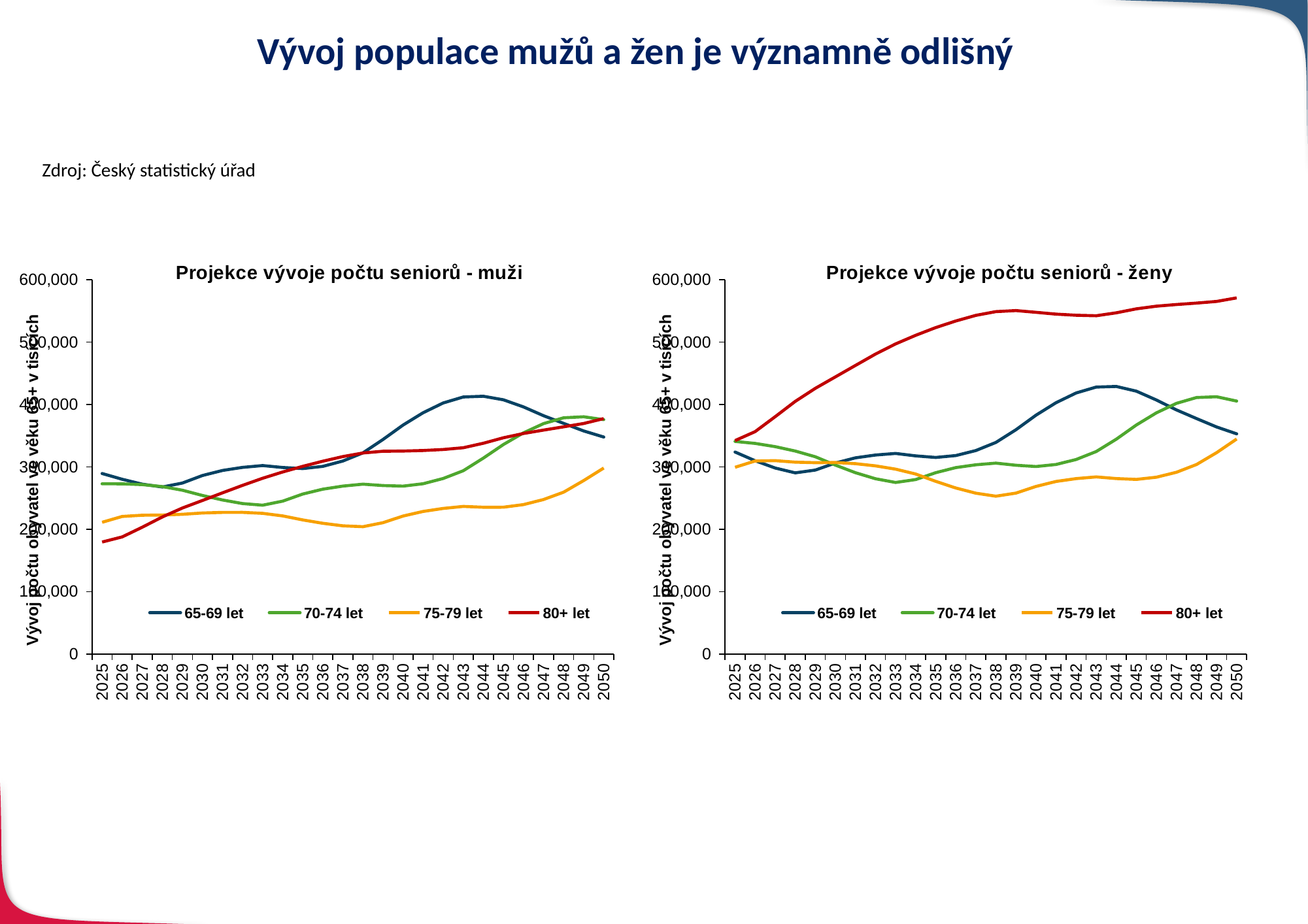
In "Projekce vývoje počtu seniorů - muži", which series has the lowest value in 2025? 80+ let In "Projekce vývoje počtu seniorů - ženy", which series has the highest value in 2050? 80+ let In "Projekce vývoje počtu seniorů - muži", is the value for 80+ let in 2025 greater or less than 200,000? less How many years are shown on the x axis of "Projekce vývoje počtu seniorů - muži"? 26 In "Projekce vývoje počtu seniorů - muži", which is larger in 2025: 65-69 let or 80+ let? 65-69 let What colour is the 80+ let line in the charts? red In "Projekce vývoje počtu seniorů - muži", is the value for 65-69 let in 2044 greater or less than 400,000? greater How many series does the legend of "Projekce vývoje počtu seniorů - ženy" list? 4 In "Projekce vývoje počtu seniorů - ženy", is the value for 80+ let in 2050 greater or less than 500,000? greater In "Projekce vývoje počtu seniorů - ženy", does the 80+ let series rise or fall from 2025 to 2050? rise What kind of chart is "Projekce vývoje počtu seniorů - muži"? line chart